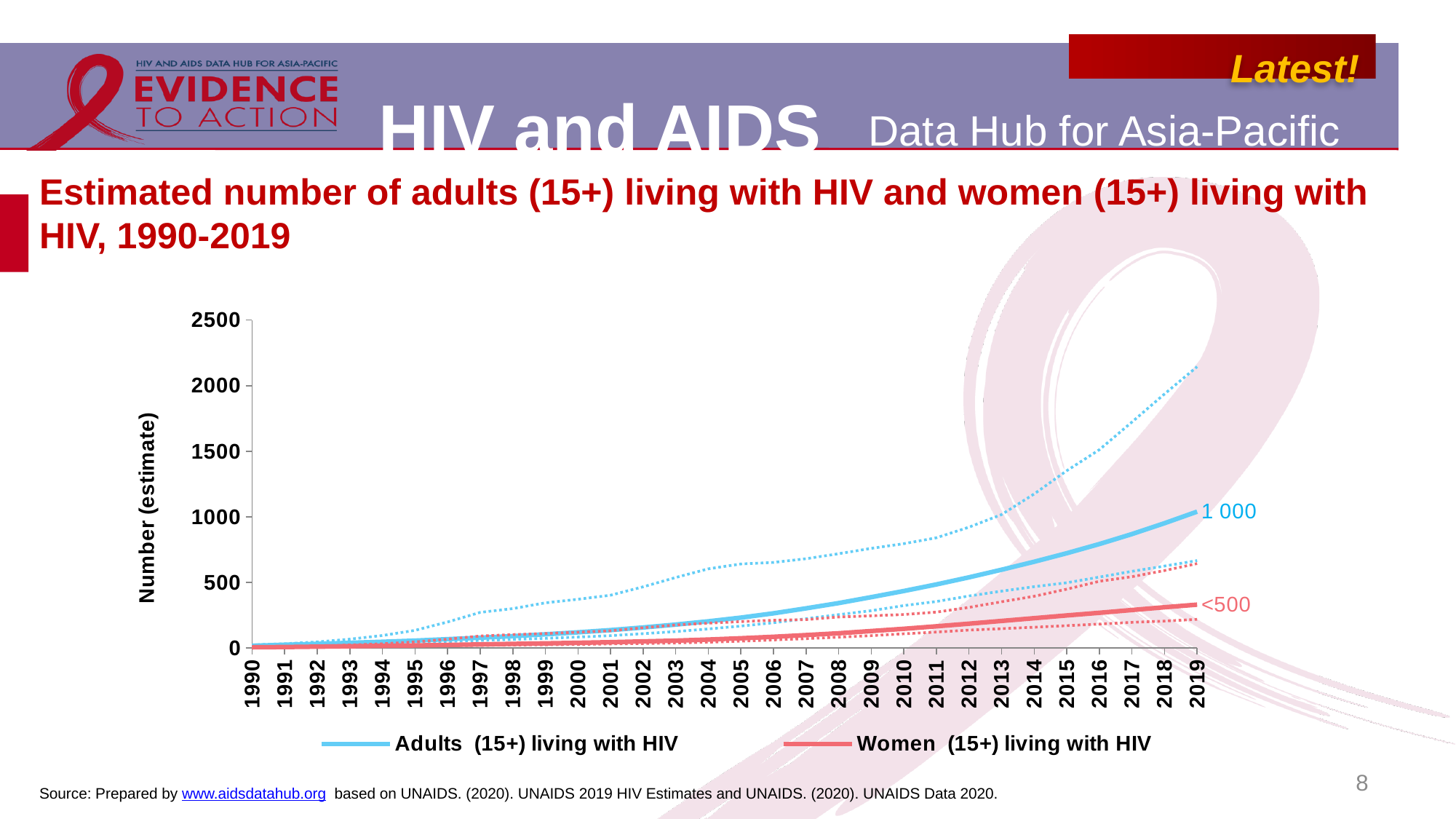
How many years are shown along the x axis of the chart? 30 In which year does the Adults (15+) living with HIV line reach its highest value? 2019 What kind of chart is shown on the slide? line chart Is the value for Adults (15+) living with HIV in 2019 greater or less than 500? greater In 2019, which series has the larger value: Adults (15+) living with HIV or Women (15+) living with HIV? Adults (15+) living with HIV Does the Adults (15+) living with HIV line rise or fall from 1990 to 2019? rise What is the labelled value for Adults (15+) living with HIV in 2019? 1 000 What is the labelled value for Women (15+) living with HIV in 2019? <500 How many series does the chart legend list? 2 Is the value for Adults (15+) living with HIV in 2010 greater or less than 500? less What colour is the line for Women (15+) living with HIV? red What is the title of the vertical axis of the chart? Number (estimate)